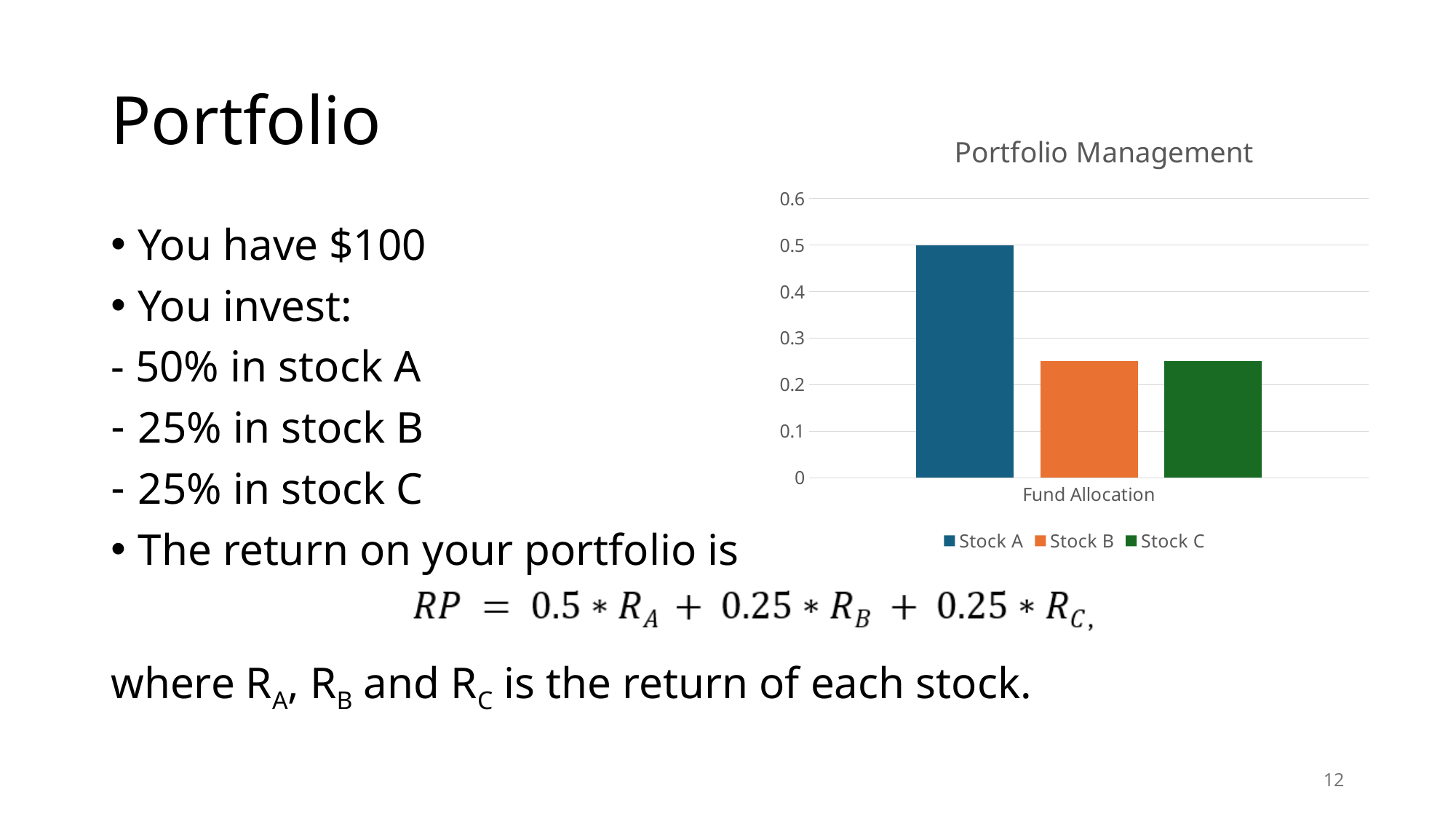
Which is larger in the chart, the value for Stock A or the value for Stock B? Stock A How many series does the chart legend list? 3 What is the value for Stock A in the chart? 0.5 Which series has the highest bar in the chart? Stock A Which is larger in the chart, the value for Stock C or the value for Stock A? Stock A Is the value for Stock B greater or less than 0.3? less Is the value for Stock C greater or less than 0.2? greater What type of chart is shown on the slide? bar chart What is the label of the category on the x axis of the chart? Fund Allocation Is the value for Stock A greater or less than 0.4? greater How many categories are shown on the x axis of the chart? 1 What is the title of the chart? Portfolio Management